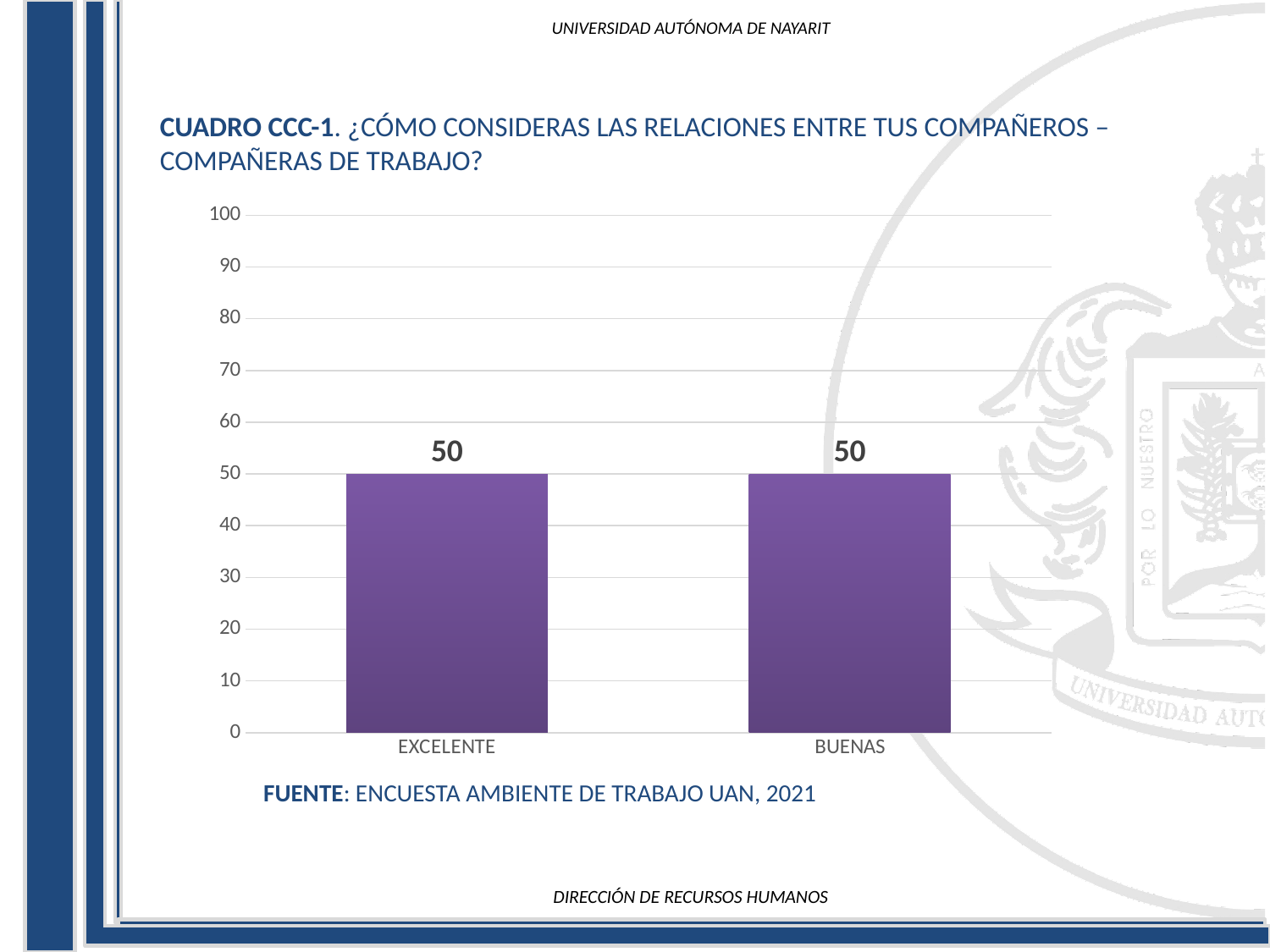
What is the difference between the values for EXCELENTE and BUENAS? 0 What is the total of the values for EXCELENTE and BUENAS? 100 What is the value for BUENAS? 50 What source is cited below the chart? ENCUESTA AMBIENTE DE TRABAJO UAN, 2021 Is the value for EXCELENTE greater or less than 40? greater What is the value for EXCELENTE? 50 What kind of chart is shown on the slide? bar chart What is the highest value shown on the y axis? 100 How many categories are shown on the x axis? 2 Is the value for BUENAS greater or less than 60? less